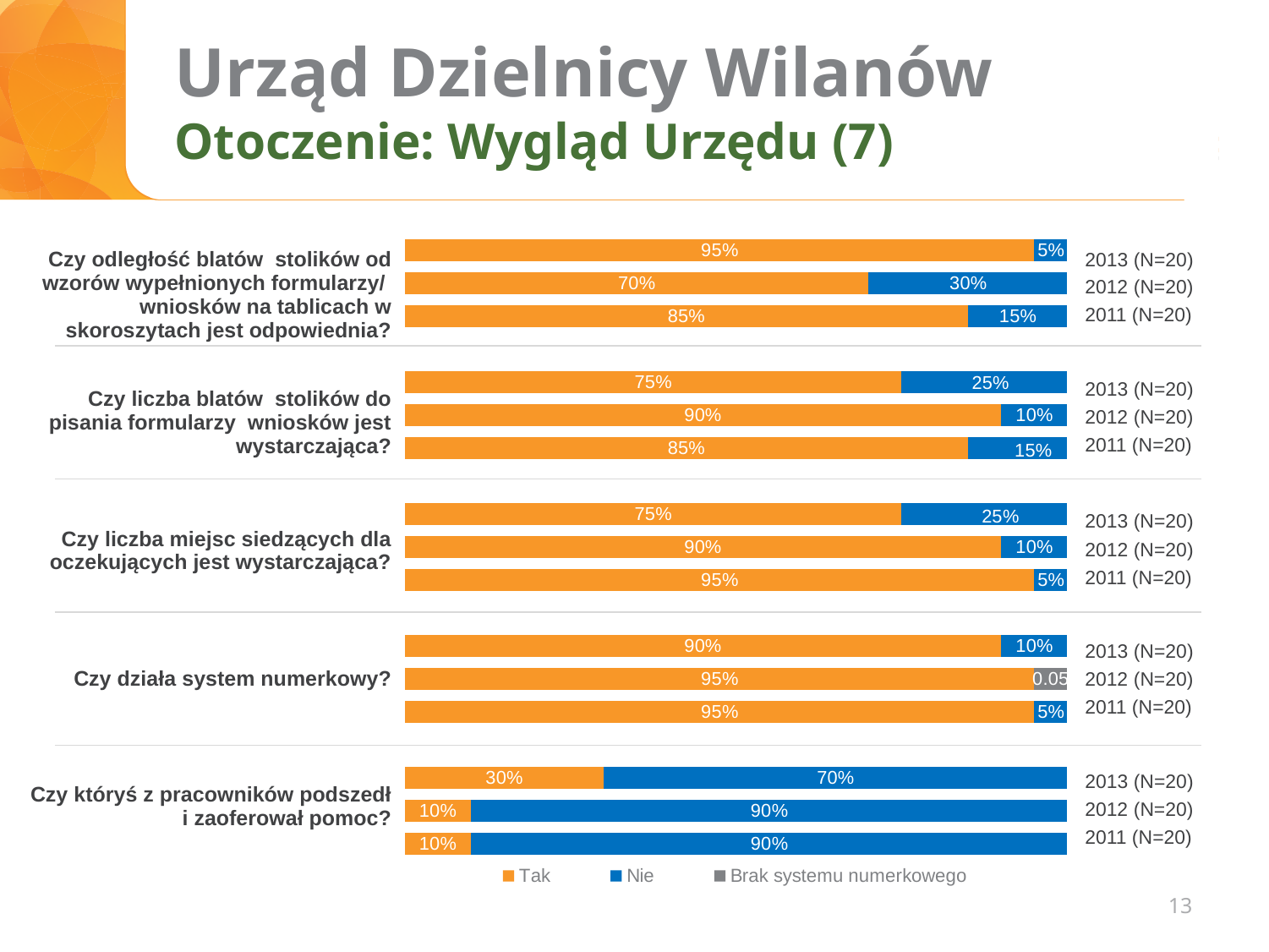
In the chart for "Czy działa system numerkowy?", what value is shown for "Brak systemu numerkowego" in 2012 (N=20)? 0.05 In the chart for "Czy któryś z pracowników podszedł i zaoferował pomoc?", is the "Tak" value for 2013 (N=20) larger or smaller than the "Nie" value for the same year? smaller In the chart for "Czy liczba blatów stolików do pisania formularzy wniosków jest wystarczająca?", which year has the highest "Tak" value? 2012 (N=20) What kind of chart is used on this slide? Stacked bar chart In the chart for "Czy działa system numerkowy?", what is the "Tak" value for 2013 (N=20)? 90% In the chart for "Czy odległość blatów stolików od wzorów wypełnionych formularzy/wniosków na tablicach w skoroszytach jest odpowiednia?", what is the "Tak" value for 2013 (N=20)? 95% How many series does the legend at the bottom of the slide list? 3 In the chart for "Czy liczba miejsc siedzących dla oczekujących jest wystarczająca?", which year has the lowest "Tak" value? 2013 (N=20) In the chart for "Czy odległość blatów stolików od wzorów wypełnionych formularzy/wniosków na tablicach w skoroszytach jest odpowiednia?", what is the "Nie" value for 2012 (N=20)? 30% In the chart for "Czy któryś z pracowników podszedł i zaoferował pomoc?", what is the "Nie" value for 2011 (N=20)? 90% In the chart for "Czy liczba blatów stolików do pisania formularzy wniosków jest wystarczająca?", what is the difference between the "Tak" values for 2012 (N=20) and 2013 (N=20)? 15% In the chart for "Czy liczba miejsc siedzących dla oczekujących jest wystarczająca?", what is the "Nie" value for 2011 (N=20)? 5%